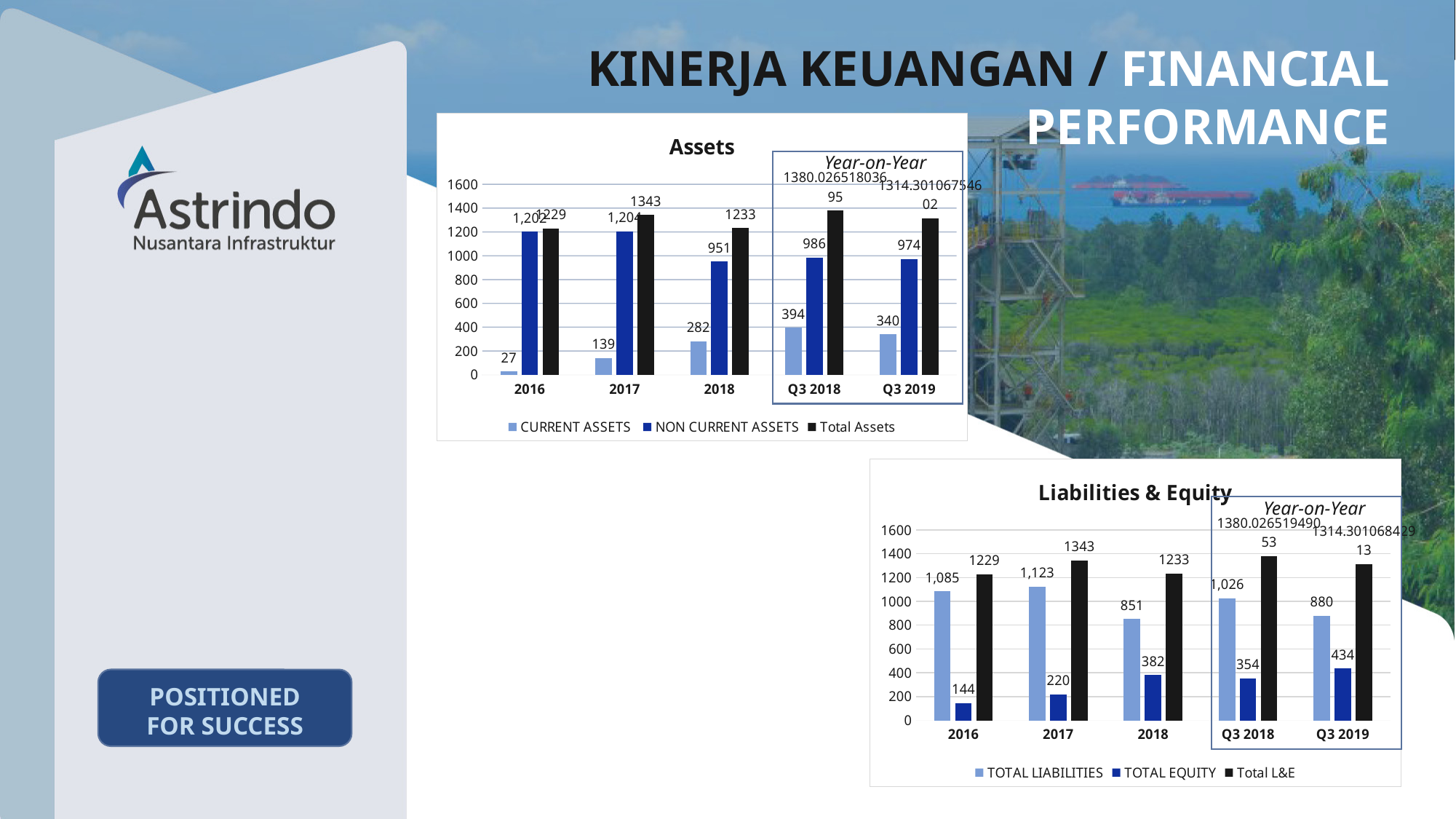
In the Liabilities & Equity chart, what is the value of TOTAL LIABILITIES for 2018? 851 In the Assets chart, what is the value of NON CURRENT ASSETS for 2017? 1,204 What kind of chart is the Assets chart? Bar chart In the Liabilities & Equity chart, is the value of Total L&E for Q3 2018 greater or less than 1200? greater In the Assets chart, what is the value of CURRENT ASSETS for 2016? 27 In the Liabilities & Equity chart, what is the value of TOTAL EQUITY for Q3 2019? 434 In the Liabilities & Equity chart, is TOTAL EQUITY larger in 2018 or in Q3 2018? 2018 In the Assets chart, which period has the lowest CURRENT ASSETS? 2016 In the Liabilities & Equity chart, which period has the highest TOTAL LIABILITIES? 2017 In the Assets chart, what is the difference between Total Assets in 2017 and in 2016? 114 How many series does the legend of the Assets chart list? 3 In the Assets chart, which period has the highest CURRENT ASSETS? Q3 2018